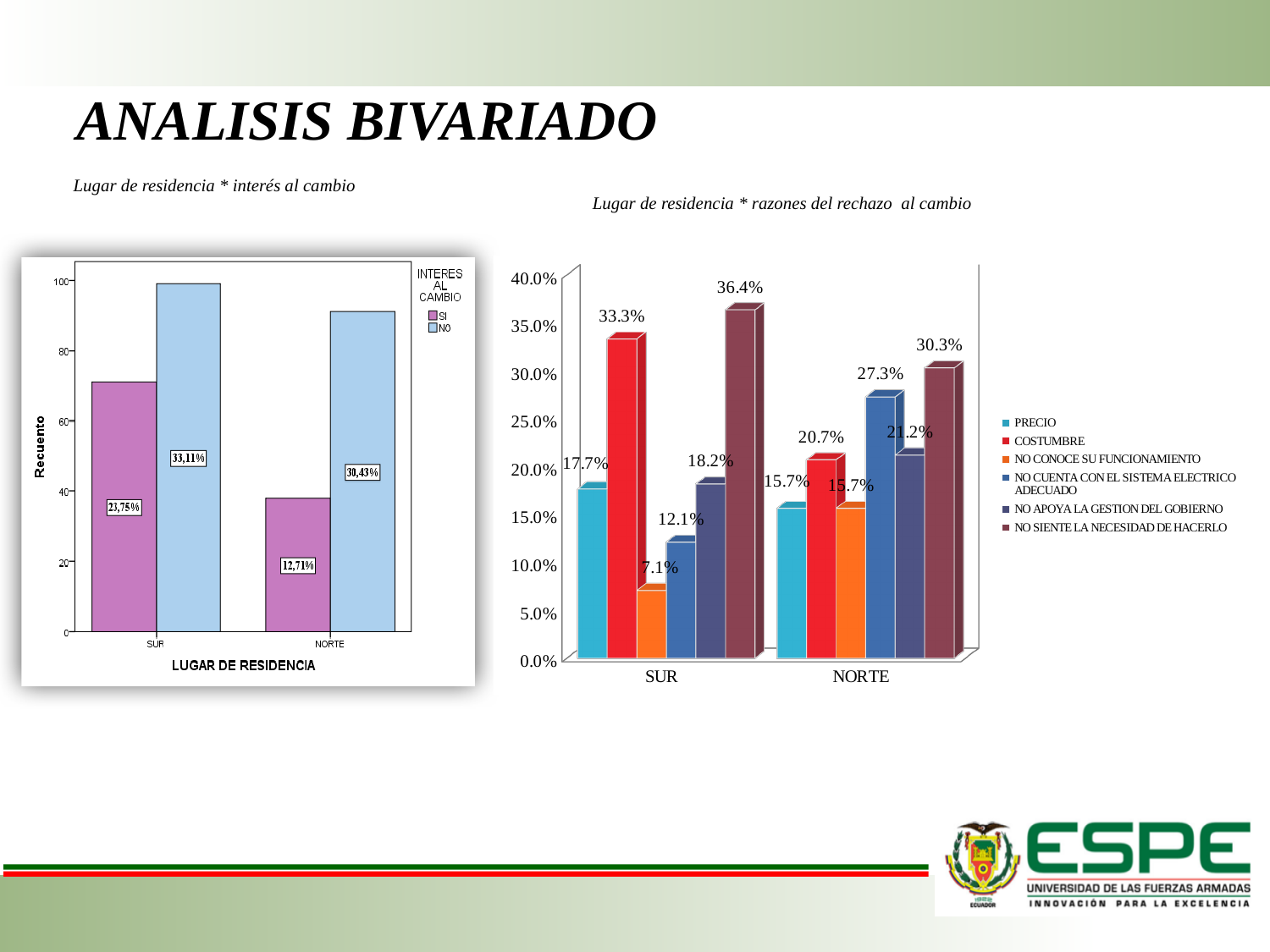
In the chart titled 'Lugar de residencia * interés al cambio', is the Recuento value of the SI bar for NORTE greater or less than 60? less In the chart titled 'Lugar de residencia * razones del rechazo al cambio', how many series does the legend list? 6 In the chart titled 'Lugar de residencia * razones del rechazo al cambio', which reason has the lowest value in SUR? NO CONOCE SU FUNCIONAMIENTO In the chart titled 'Lugar de residencia * interés al cambio', what is the data label on the SI bar for SUR? 23,75% In the chart titled 'Lugar de residencia * interés al cambio', what is the data label on the NO bar for NORTE? 30,43% In the chart titled 'Lugar de residencia * razones del rechazo al cambio', which is larger: COSTUMBRE in SUR or COSTUMBRE in NORTE? COSTUMBRE in SUR In the chart titled 'Lugar de residencia * razones del rechazo al cambio', what is the value for NO APOYA LA GESTION DEL GOBIERNO in NORTE? 21.2% In the chart titled 'Lugar de residencia * razones del rechazo al cambio', what is the difference between NO SIENTE LA NECESIDAD DE HACERLO in SUR and in NORTE? 6.1% In the chart titled 'Lugar de residencia * razones del rechazo al cambio', what is the value for COSTUMBRE in SUR? 33.3% What kind of chart is the one titled 'Lugar de residencia * interés al cambio'? Bar chart In the chart titled 'Lugar de residencia * razones del rechazo al cambio', what is the value for NO CUENTA CON EL SISTEMA ELECTRICO ADECUADO in NORTE? 27.3% In the chart titled 'Lugar de residencia * razones del rechazo al cambio', which reason has the highest value in SUR? NO SIENTE LA NECESIDAD DE HACERLO